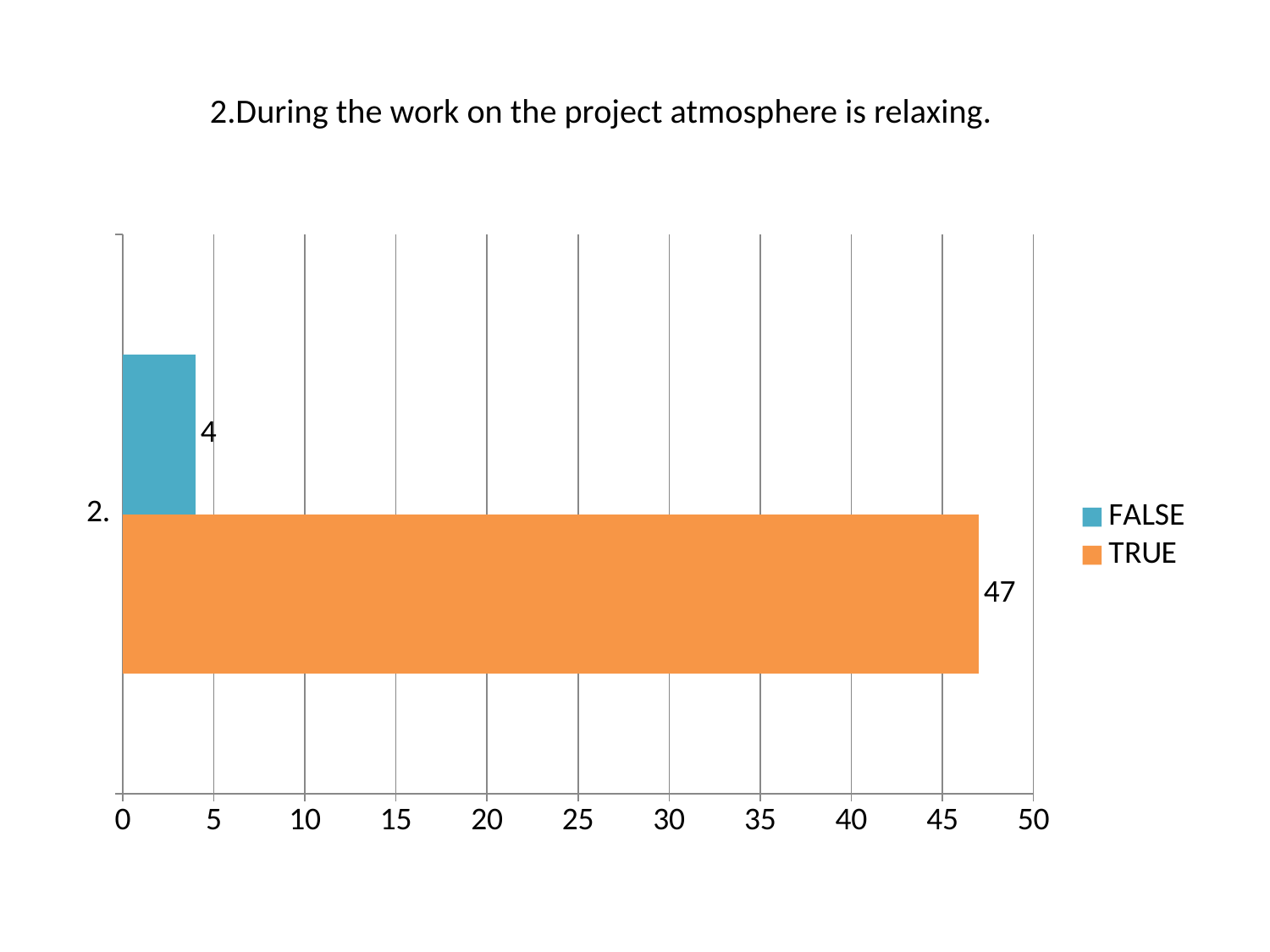
What kind of chart is shown on the slide? bar chart What colour is the TRUE bar? orange What is the difference between the TRUE and FALSE values? 43 Which series has the higher value, TRUE or FALSE? TRUE What is the title of the chart? 2.During the work on the project atmosphere is relaxing. Is the value for FALSE greater or less than 5? less How many series does the legend list? 2 Which series has the lower value? FALSE What is the value for FALSE? 4 Is the value for TRUE greater or less than 45? greater What is the maximum value shown on the horizontal axis? 50 What is the value for TRUE? 47